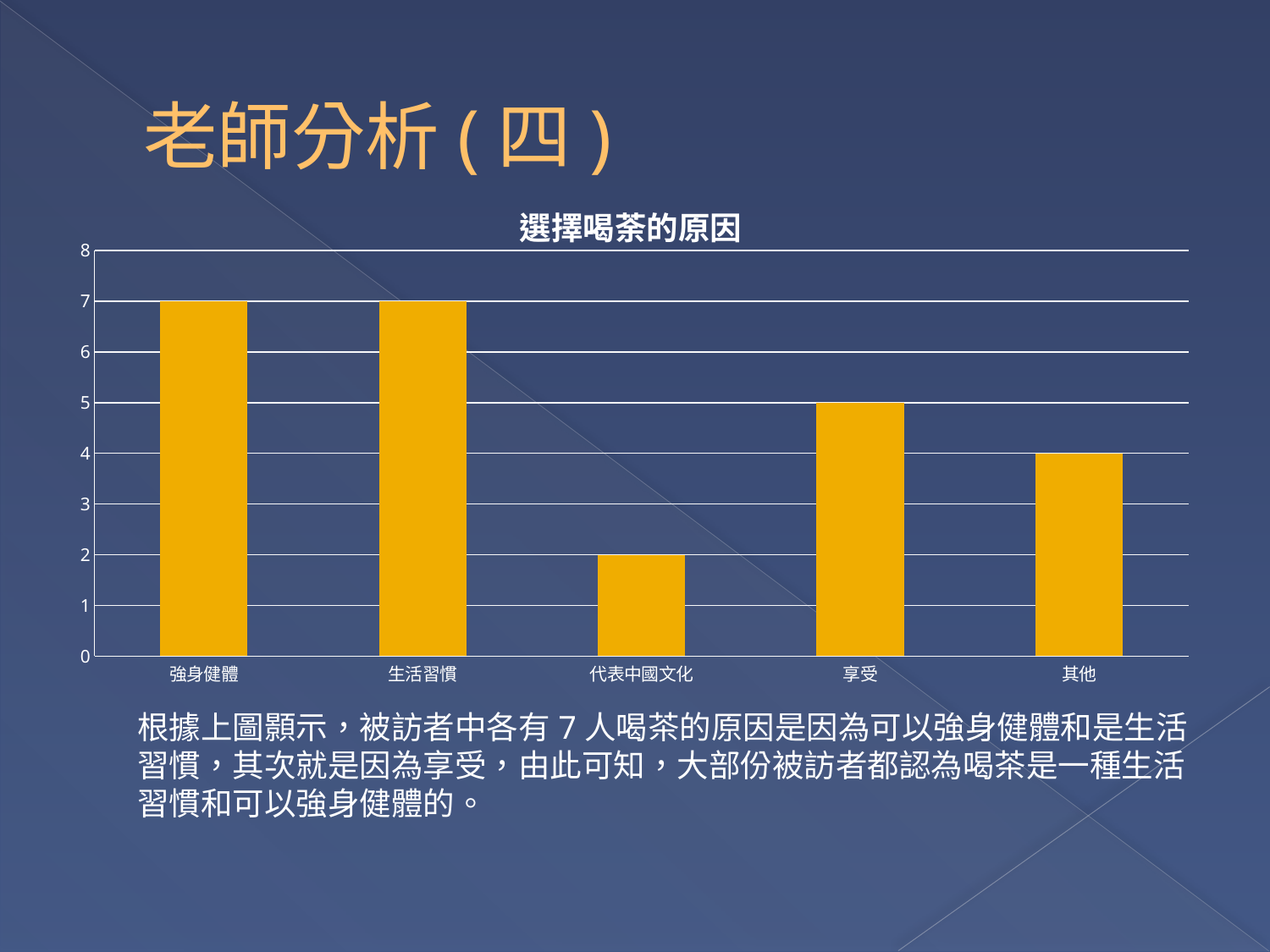
What is the value for 享受? 5 What type of chart is shown on the slide? bar chart Which category has the lowest value? 代表中國文化 Which is larger, the value for 享受 or the value for 其他? 享受 What is the value for 代表中國文化? 2 What is the value for 強身健體? 7 What is the value for 其他? 4 What is the difference between the value for 生活習慣 and the value for 代表中國文化? 5 How many categories are shown on the x axis of the chart? 5 What is the highest value shown on the y axis? 8 Is the value for 其他 greater or less than 3? greater What is the title of the chart? 選擇喝荼的原因